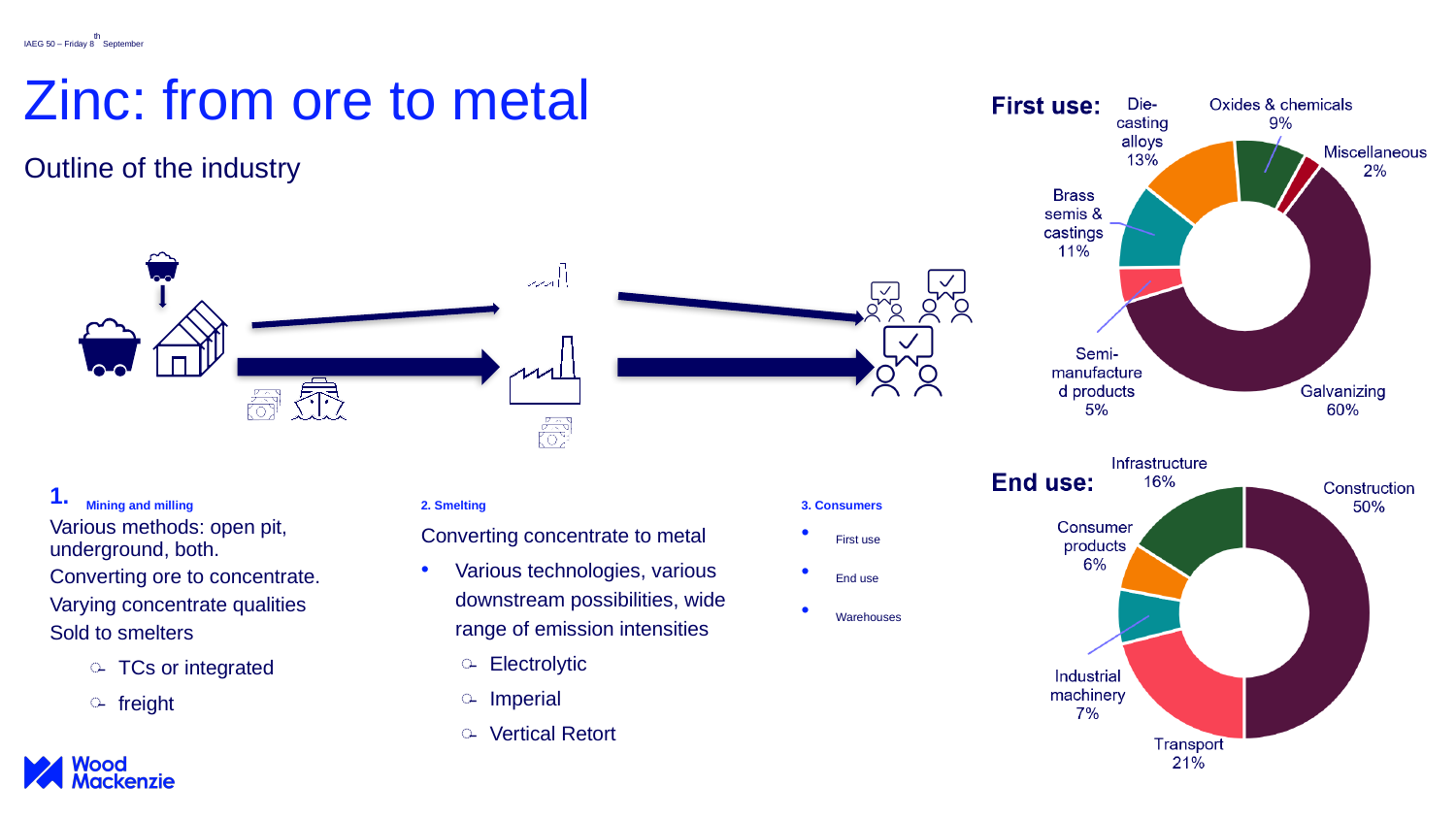
In the End use chart, what share does Construction have? 50% In the First use chart, what is the difference between the shares of Brass semis & castings and Oxides & chemicals? 2% In the First use chart, which category has the smallest share? Miscellaneous In the First use chart, what share do Die-casting alloys have? 13% In the End use chart, what is the difference between the shares of Infrastructure and Industrial machinery? 9% In the First use chart, what share does Galvanizing have? 60% In the End use chart, which category has the largest share? Construction In the First use chart, which is larger: Die-casting alloys or Semi-manufactured products? Die-casting alloys In the End use chart, how many categories are shown? 5 What kind of chart is the End use chart? Pie (donut) chart In the First use chart, how many categories are shown? 6 In the End use chart, what share does Transport have? 21%